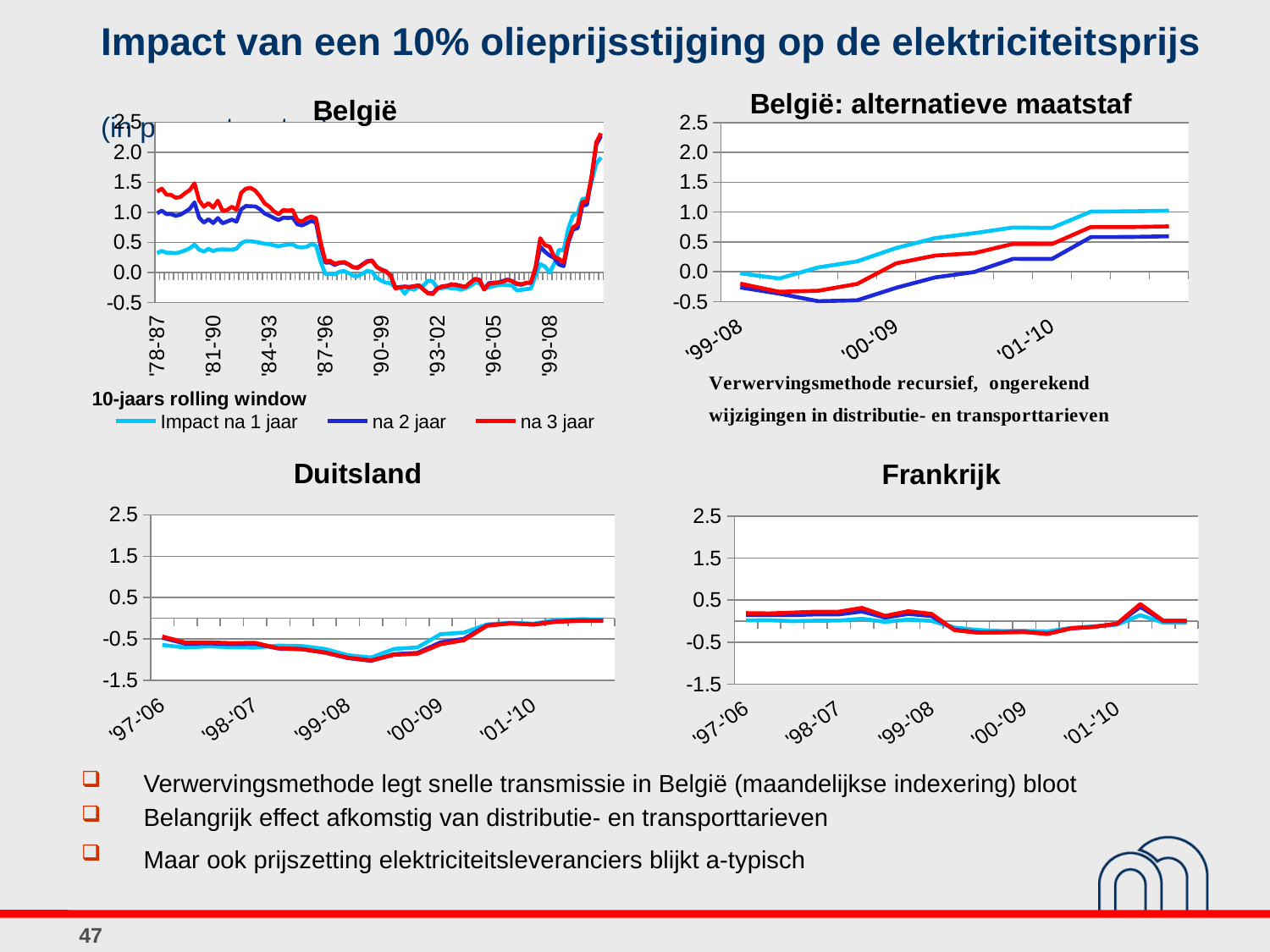
In the 'België' chart, do the lines rise or fall between '87-'96 and '90-'99? fall In the 'België' chart, is the value of 'Impact na 1 jaar' at '78-'87 greater or less than 0.5? less In the 'België: alternatieve maatstaf' chart, do the lines rise or fall from '99-'08 to '01-'10? rise In the 'Frankrijk' chart, is the value of 'na 3 jaar' at '97-'06 greater or less than 0.5? less How many series does the legend under the 'België' chart list? 3 In the 'België' chart, is the final value of 'na 3 jaar' at the right end of the x axis greater or less than 2.0? greater What is the title of the chart at the bottom right of the slide? Frankrijk In the 'Duitsland' chart, do the lines rise or fall from '99-'08 to '01-'10? rise What kind of chart is the 'België' chart at the top left? line chart